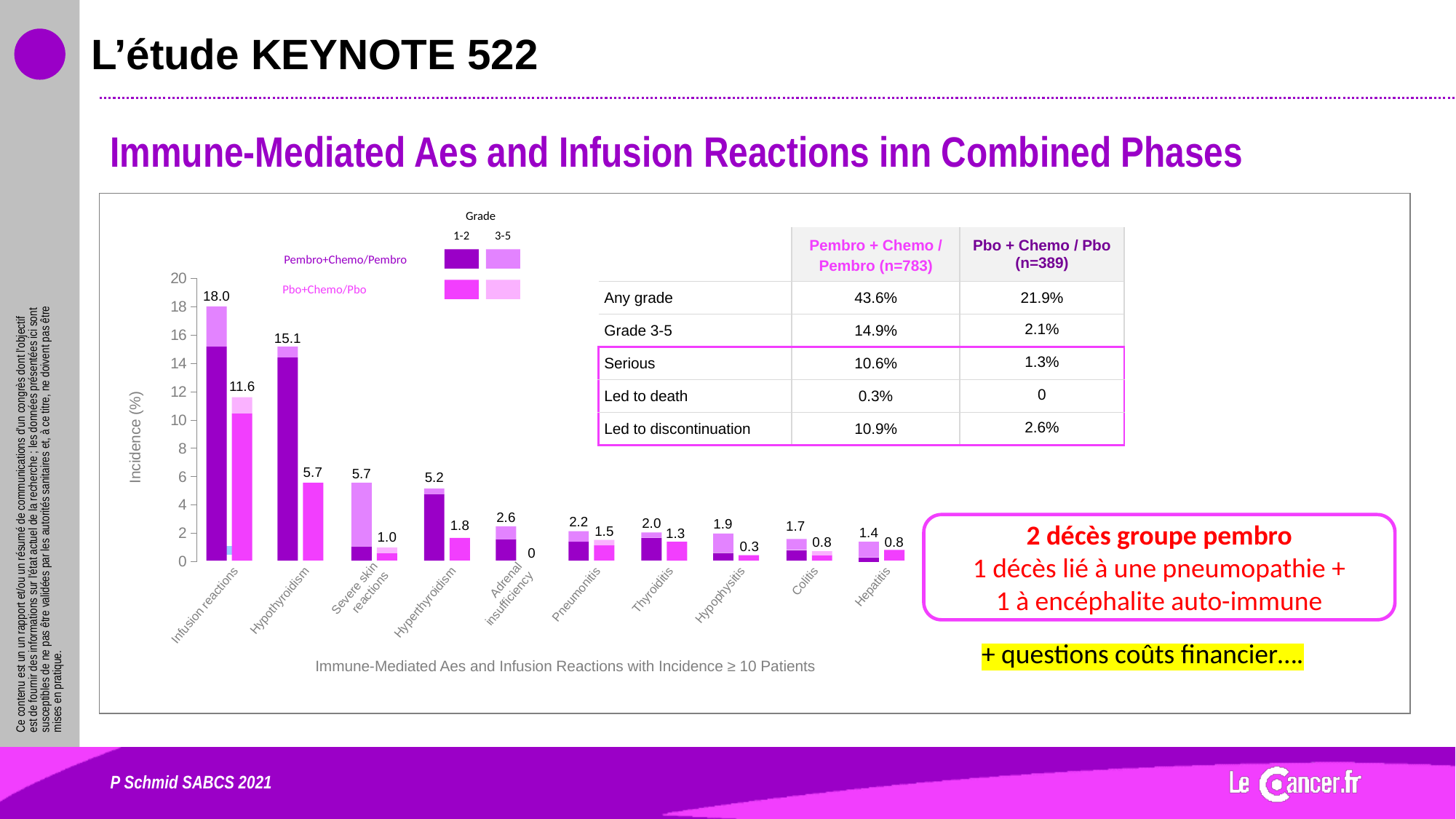
What is the incidence (%) of adrenal insufficiency in the Pbo+Chemo/Pbo group? 0 Do the Pembro+Chemo/Pembro incidence values rise or fall from left to right across the categories? Fall What is the label of the y axis of the chart? Incidence (%) Which group has the higher incidence of severe skin reactions, Pembro+Chemo/Pembro or Pbo+Chemo/Pbo? Pembro+Chemo/Pembro What is the difference in incidence (%) of infusion reactions between the Pembro+Chemo/Pembro and Pbo+Chemo/Pbo groups? 6.4 What is the incidence (%) of infusion reactions in the Pembro+Chemo/Pembro group? 18.0 Which adverse event has the lowest incidence in the Pembro+Chemo/Pembro group? Hepatitis What is the difference in incidence (%) of hypothyroidism between the Pembro+Chemo/Pembro and Pbo+Chemo/Pbo groups? 9.4 How many adverse event categories are shown on the x axis of the chart? 10 Which adverse event has the highest incidence in the Pembro+Chemo/Pembro group? Infusion reactions What kind of chart is used to show the immune-mediated AEs and infusion reactions? Bar chart What is the incidence (%) of hypothyroidism in the Pbo+Chemo/Pbo group? 5.7